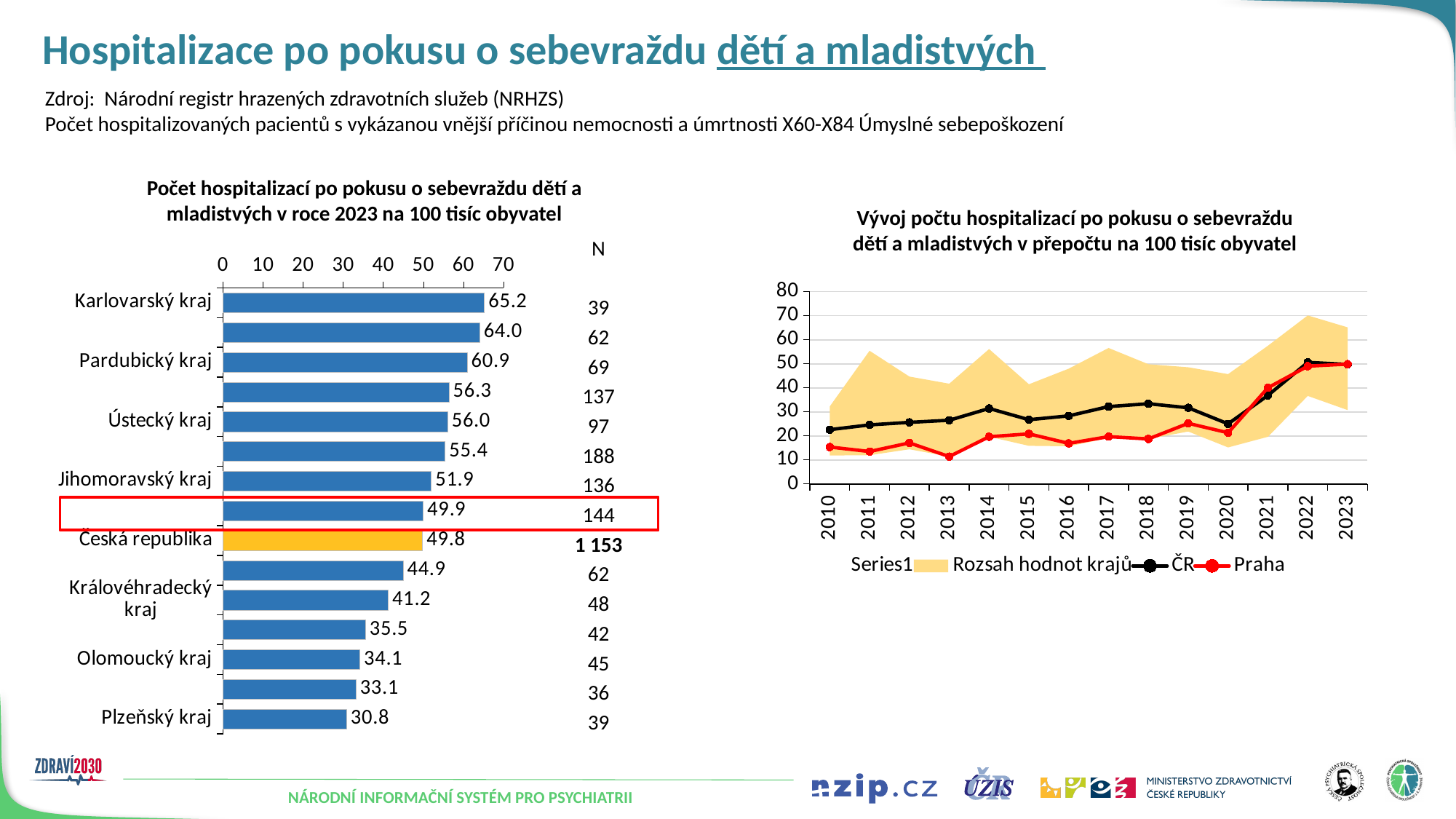
What kind of chart is the right chart (Vývoj počtu hospitalizací...)? A combination area and line chart (lines for ČR and Praha with a shaded area for the range of regional values) In the left bar chart, what is the value for Česká republika? 49.8 In the left bar chart, what is the value for Plzeňský kraj? 30.8 In the left bar chart, what is the difference between the values for Karlovarský kraj and Plzeňský kraj? 34.4 In the left bar chart, what is the value for Karlovarský kraj? 65.2 In the left chart, what is the N value shown for Česká republika? 1 153 In the left bar chart, which labelled region has the highest value? Karlovarský kraj In the right chart, is the ČR value for 2018 greater or less than 30? greater How many entries does the legend of the right chart list? 4 In the left bar chart, which labelled region has the lowest value? Plzeňský kraj How many bars are plotted in the left chart? 15 In the left bar chart, which has the larger value, Pardubický kraj or Ústecký kraj? Pardubický kraj